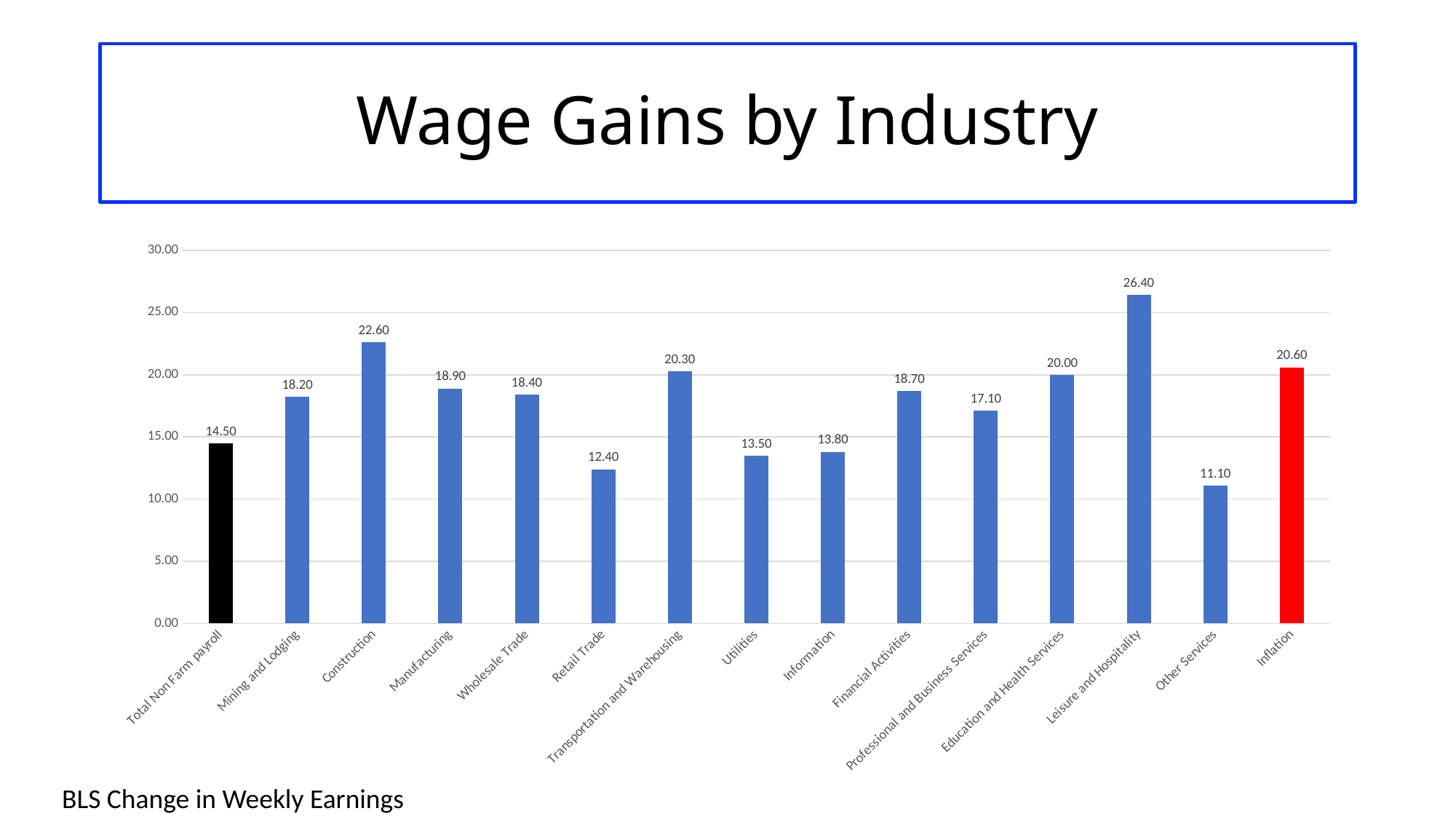
What is the value for Construction? 22.60 Which is larger, Manufacturing or Wholesale Trade? Manufacturing What colour is the Inflation bar? red How many categories are shown on the x axis? 15 Is the value for Retail Trade greater or less than 15.00? less What is the value for Total Non Farm payroll? 14.50 What is the title of the slide? Wage Gains by Industry What is the difference between Leisure and Hospitality and Other Services? 15.30 Which category has the lowest value? Other Services What kind of chart is this? bar chart What is the value for Inflation? 20.60 Which category has the highest value? Leisure and Hospitality